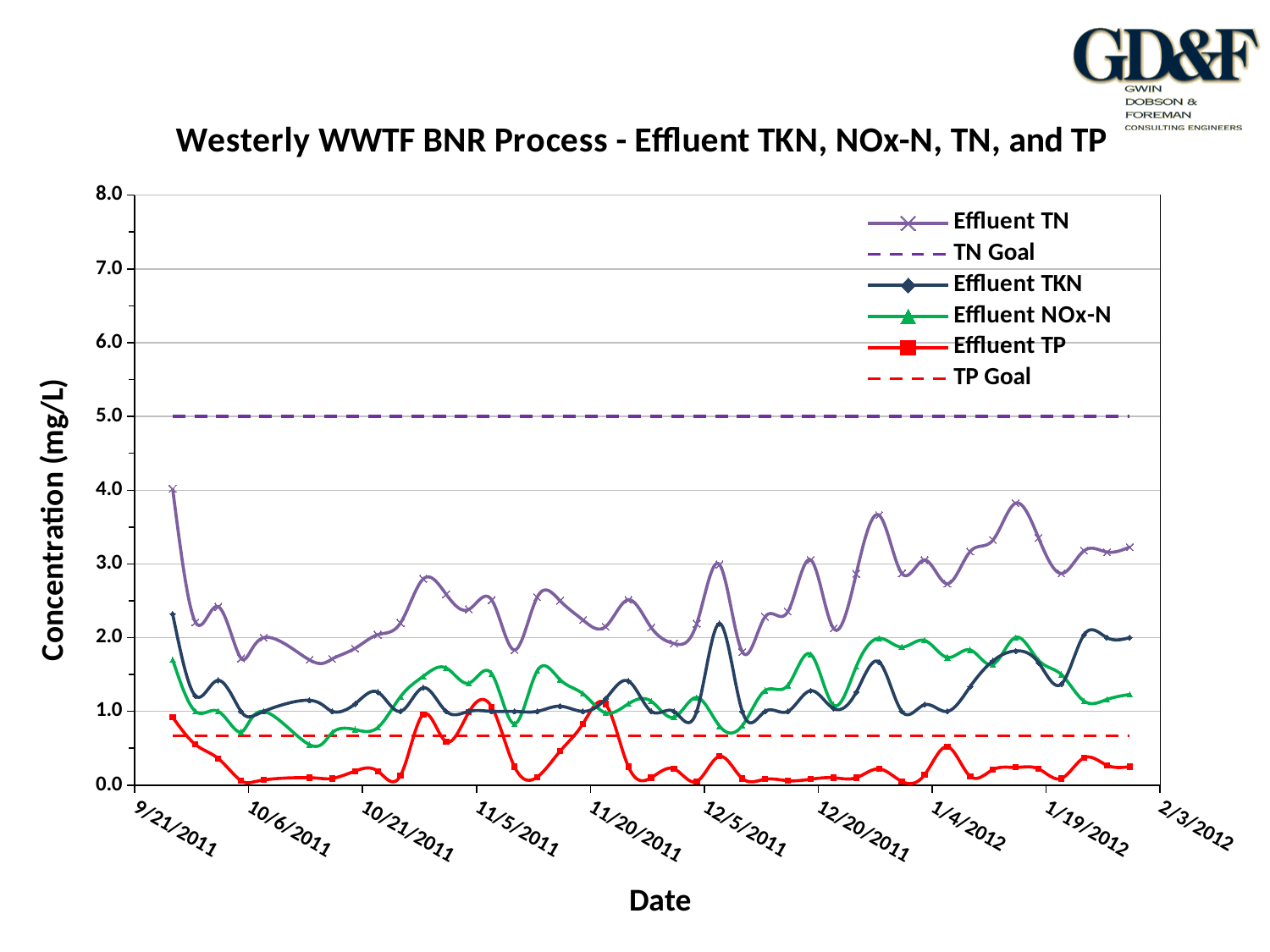
Which is higher, the TN Goal line or the TP Goal line? TN Goal What kind of chart is shown on the slide? line chart What is the title of the chart? Westerly WWTF BNR Process - Effluent TKN, NOx-N, TN, and TP How many series does the legend list? 6 What is the label of the y axis? Concentration (mg/L) Is the value for Effluent TN on 9/21/2011 greater or less than 3.0? greater Which of the measured effluent series has the highest values across the chart? Effluent TN What concentration does the TN Goal line sit at? 5.0 Does Effluent TN rise or fall between 9/21/2011 and 10/6/2011? fall Is the value for Effluent TP on 10/6/2011 greater or less than 1.0? less Is the value for Effluent TKN on 9/21/2011 greater or less than 2.0? greater Which of the measured effluent series has the lowest values across the chart? Effluent TP